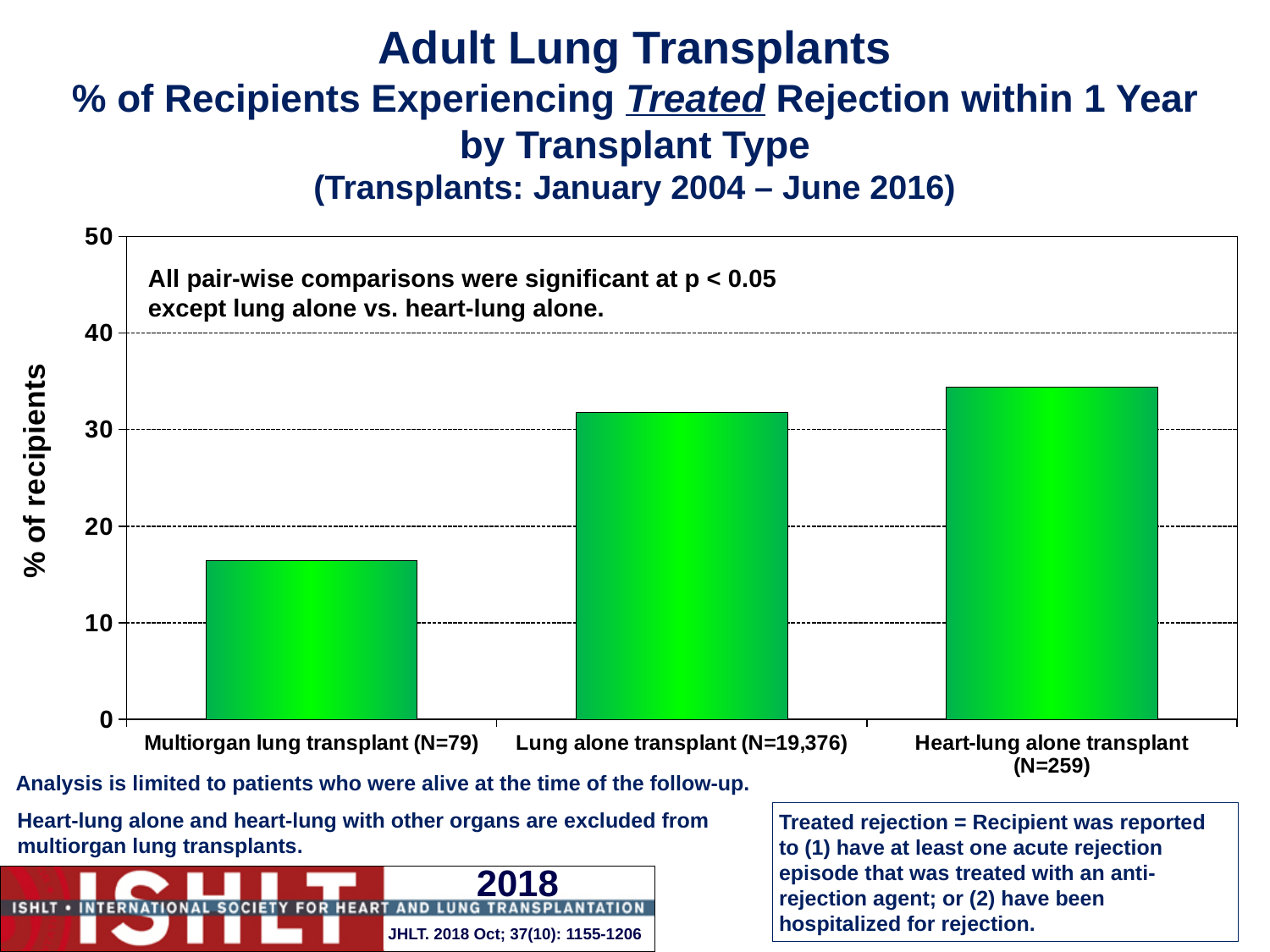
What is the maximum value shown on the y axis? 50 Is the value for Lung alone transplant (N=19,376) greater or less than 30? greater Is the value for Heart-lung alone transplant (N=259) greater or less than 40? less What is the label of the y axis? % of recipients Is the value for Multiorgan lung transplant (N=79) greater or less than 10? greater Do the bar values rise or fall moving from left to right across the transplant types? rise Which has a larger % of recipients experiencing treated rejection: Multiorgan lung transplant or Lung alone transplant? Lung alone transplant Which transplant type has the lowest % of recipients experiencing treated rejection within 1 year? Multiorgan lung transplant (N=79) How many transplant type categories are plotted in the chart? 3 Which transplant type has the highest % of recipients experiencing treated rejection within 1 year? Heart-lung alone transplant (N=259) What type of chart is shown on the slide? bar chart